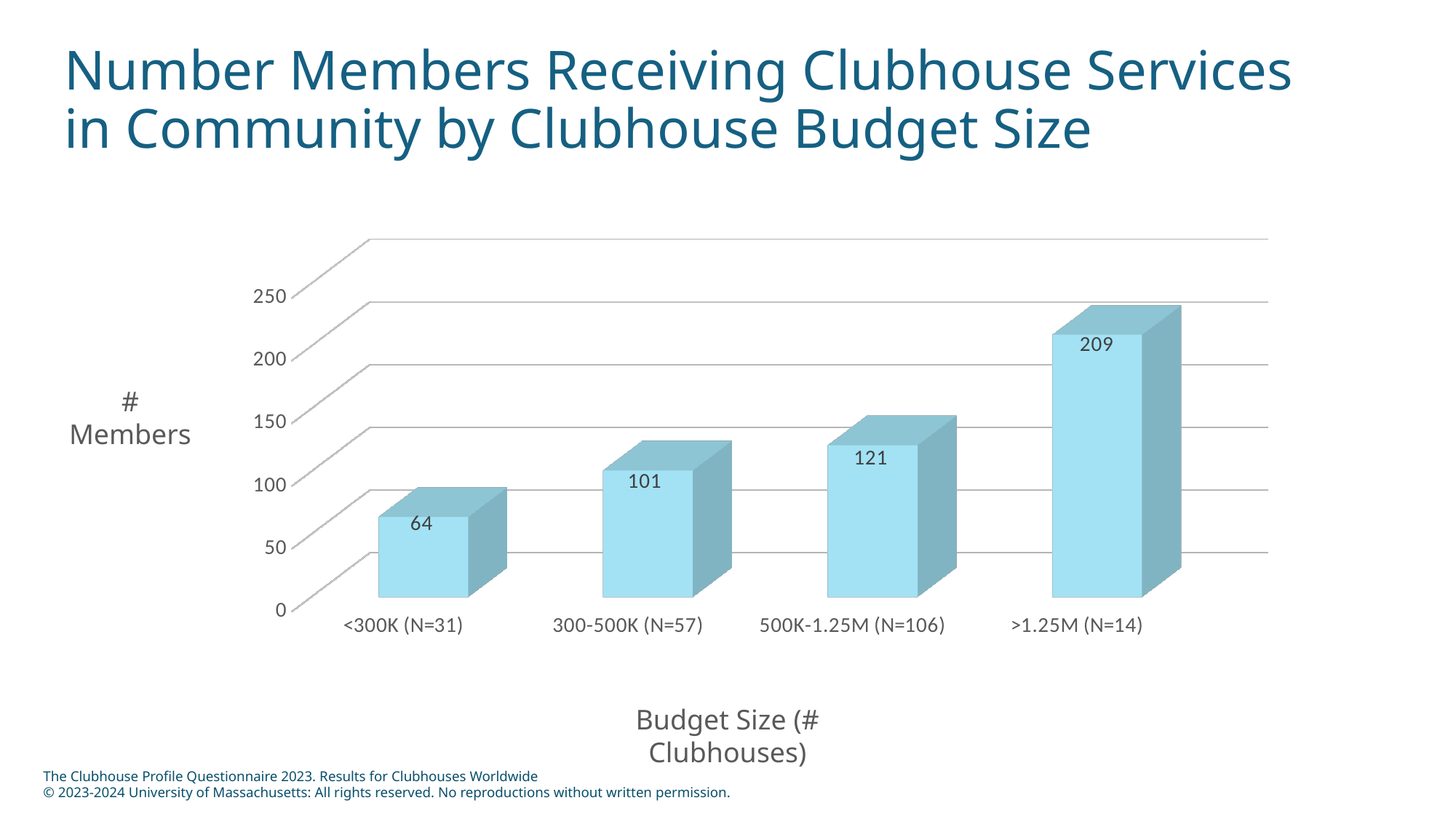
Do the values rise or fall as budget size increases along the x axis? Rise What is the value for the 300-500K (N=57) budget category? 101 What is the value for the 500K-1.25M (N=106) budget category? 121 What is the difference between the values for 500K-1.25M (N=106) and 300-500K (N=57)? 20 What is the value for the >1.25M (N=14) budget category? 209 What kind of chart is shown on the slide? Bar chart Which budget size category has the lowest number of members receiving clubhouse services in community? <300K (N=31) How many budget size categories are shown on the chart? 4 What is the number of members receiving clubhouse services in community for clubhouses with budget <300K (N=31)? 64 Which budget size category has the highest number of members receiving clubhouse services in community? >1.25M (N=14) What is the difference between the values for >1.25M (N=14) and <300K (N=31)? 145 Which is larger, the value for 300-500K (N=57) or the value for 500K-1.25M (N=106)? 500K-1.25M (N=106)